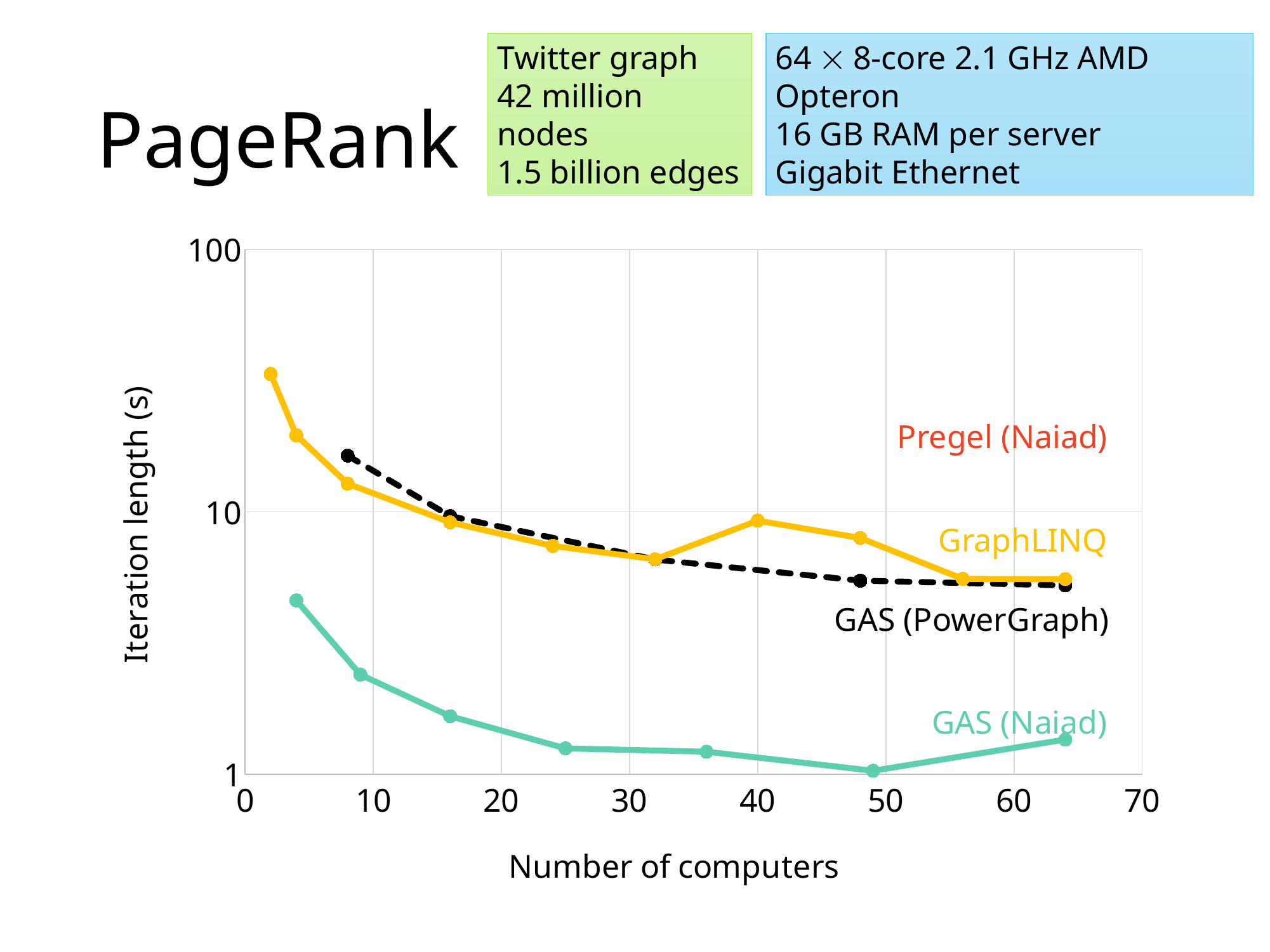
Is the iteration length for GAS (Naiad) at 4 computers greater or less than 10? less Is the iteration length for GraphLINQ at 2 computers greater or less than 10? greater At 64 computers, which has the smaller iteration length, GraphLINQ or GAS (Naiad)? GAS (Naiad) How many data points are plotted for the GAS (PowerGraph) series? 6 Does the iteration length for GraphLINQ generally rise or fall as the number of computers increases? Fall What kind of chart is shown on the slide? Line chart Is the iteration length for GraphLINQ at 64 computers greater or less than 10? less Which series has the lowest iteration length across the chart? GAS (Naiad) At 16 computers, which has the larger iteration length, GraphLINQ or GAS (Naiad)? GraphLINQ What is the label of the y axis of the chart? Iteration length (s) What is the label of the x axis of the chart? Number of computers